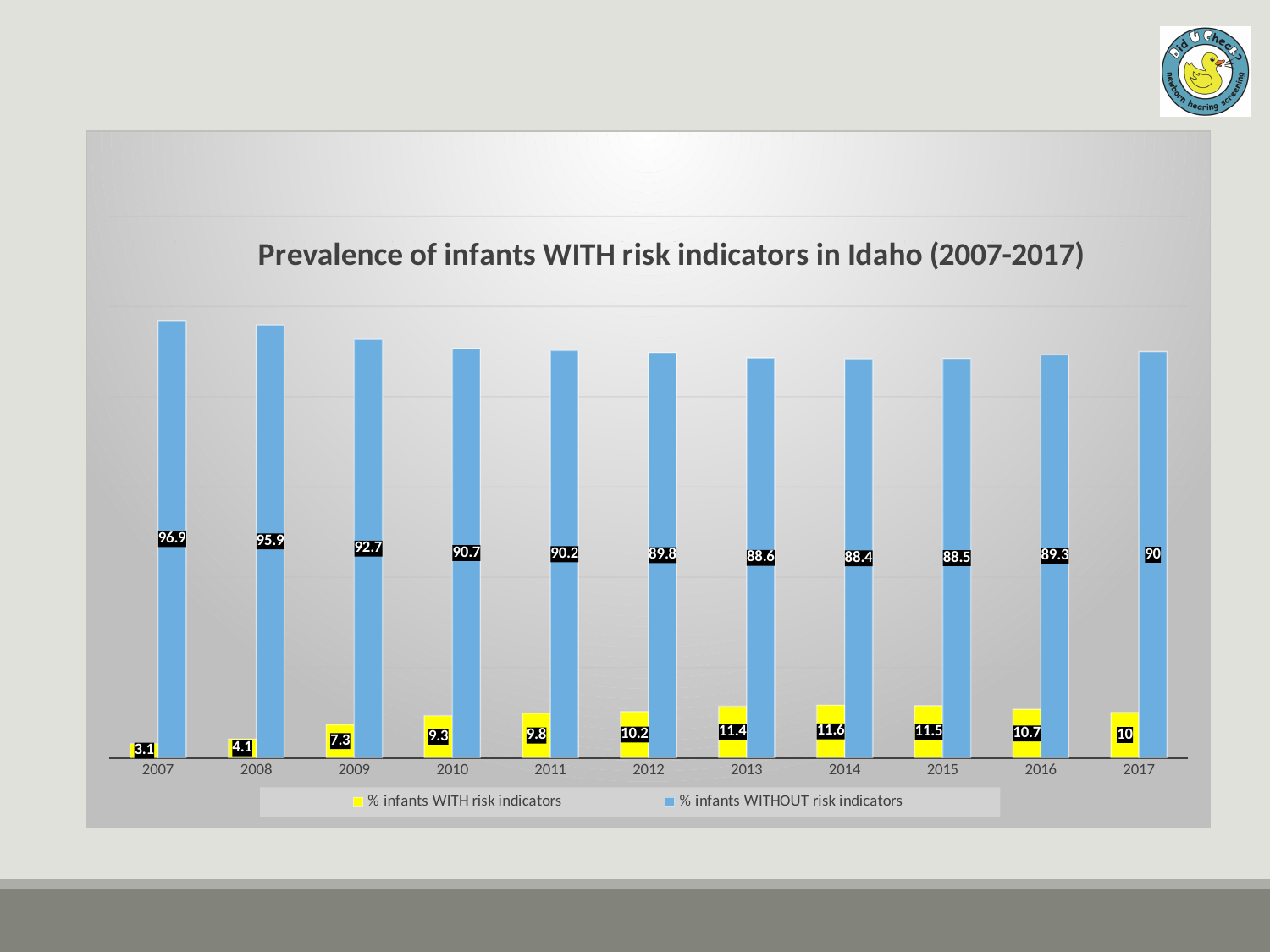
How many years are shown on the x axis? 11 What is the value for % infants WITHOUT risk indicators in 2017? 90 What is the value for % infants WITH risk indicators in 2007? 3.1 Which is larger, the % infants WITHOUT risk indicators value for 2007 or for 2009? 2007 Which year has the highest value for % infants WITH risk indicators? 2014 What is the difference between the % infants WITH risk indicators values for 2017 and 2007? 6.9 How many series does the legend list? 2 What is the value for % infants WITH risk indicators in 2014? 11.6 What is the title of the chart? Prevalence of infants WITH risk indicators in Idaho (2007-2017) Does the % infants WITHOUT risk indicators value rise or fall from 2007 to 2014? fall What kind of chart is shown on the slide? bar chart Which year has the lowest value for % infants WITHOUT risk indicators? 2014